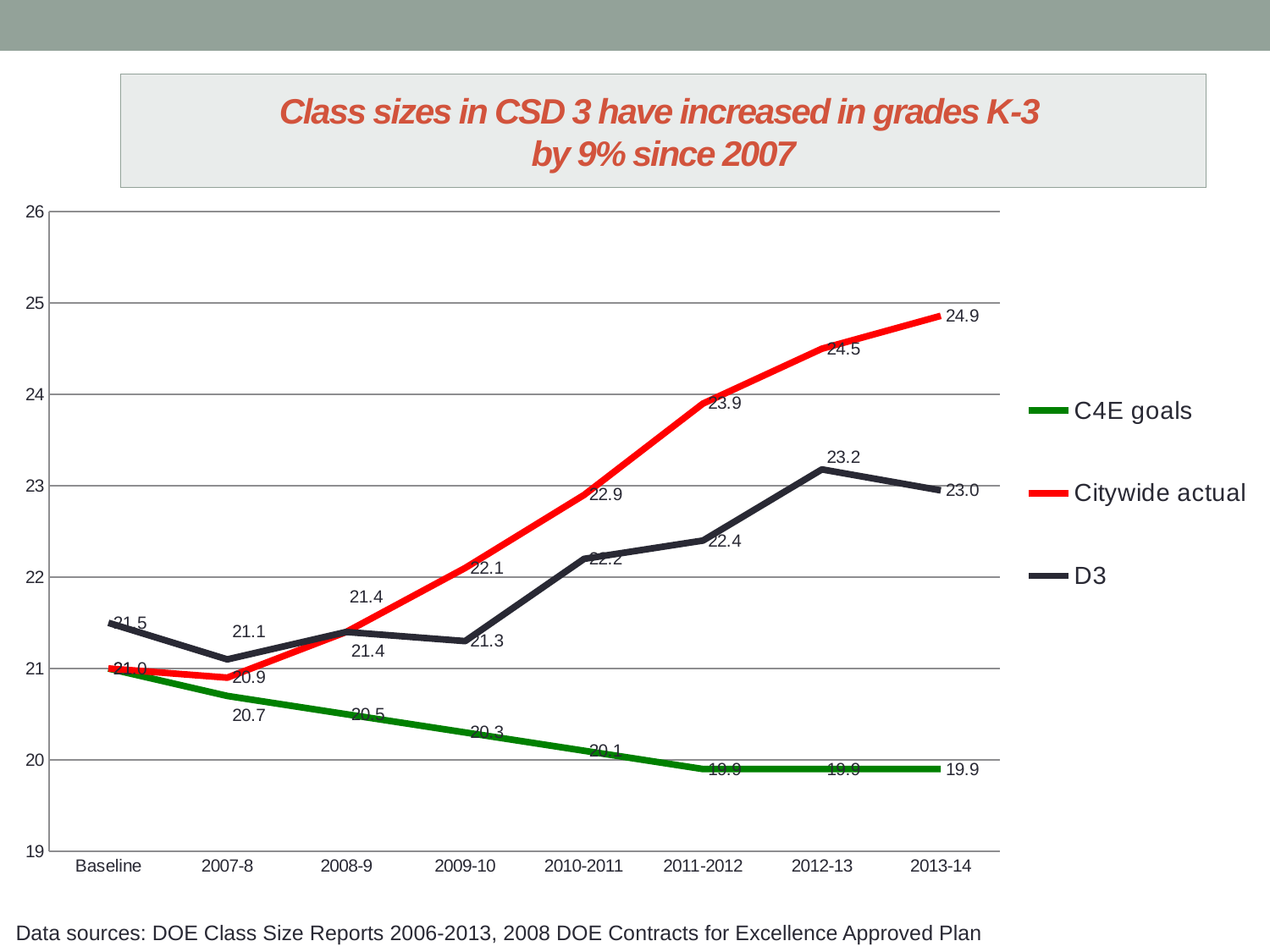
How many points are plotted along the x axis for each series? 8 In 2010-2011, which is larger: the Citywide actual value or the D3 value? Citywide actual Does the Citywide actual series rise or fall from 2008-9 to 2013-14? rises What is the D3 value at Baseline? 21.5 How many series does the legend list? 3 What is the title of the chart? Class sizes in CSD 3 have increased in grades K-3 by 9% since 2007 What is the difference between the Citywide actual and D3 values in 2013-14? 1.9 What is the D3 value for 2012-13? 23.2 In which year is the Citywide actual value highest? 2013-14 What kind of chart is shown on the slide? line chart What is the Citywide actual value for 2013-14? 24.9 What is the C4E goals value for 2007-8? 20.7